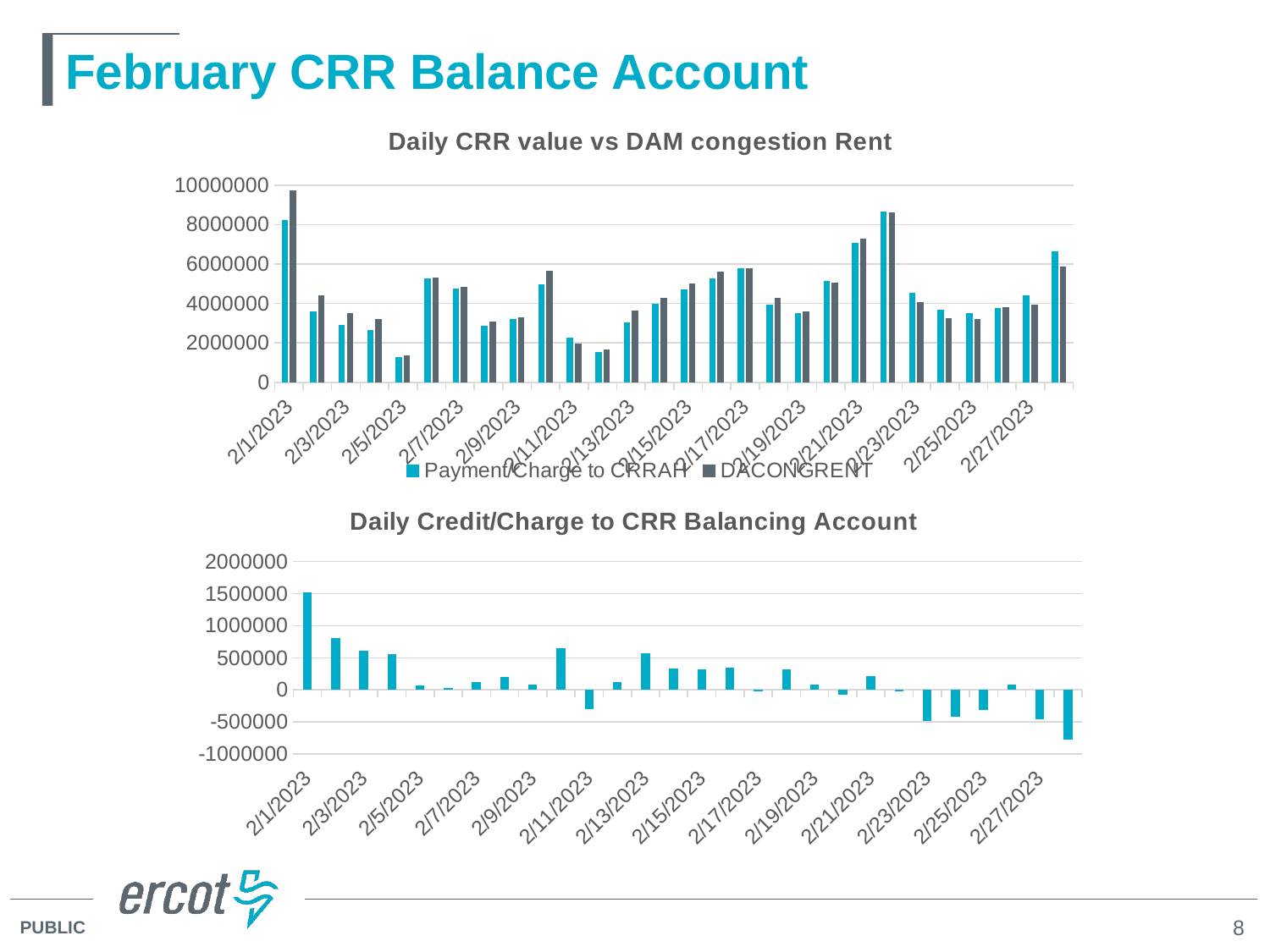
In the top chart, 'Daily CRR value vs DAM congestion Rent', is the Payment/Charge to CRRAH value for 2/22/2023 greater or less than 8000000? greater In the top chart, 'Daily CRR value vs DAM congestion Rent', what are the two legend entries? Payment/Charge to CRRAH and DACONGRENT In the top chart, 'Daily CRR value vs DAM congestion Rent', is the DACONGRENT value for 2/1/2023 greater or less than 8000000? greater In the top chart, 'Daily CRR value vs DAM congestion Rent', how many series does the legend list? 2 What kind of chart is the bottom chart, 'Daily Credit/Charge to CRR Balancing Account'? bar chart In the bottom chart, 'Daily Credit/Charge to CRR Balancing Account', on which date is the value lowest? 2/28/2023 In the bottom chart, 'Daily Credit/Charge to CRR Balancing Account', is the value for 2/1/2023 greater or less than 1000000? greater In the top chart, 'Daily CRR value vs DAM congestion Rent', which is larger on 2/1/2023: Payment/Charge to CRRAH or DACONGRENT? DACONGRENT In the bottom chart, 'Daily Credit/Charge to CRR Balancing Account', which date has the larger value: 2/2/2023 or 2/3/2023? 2/2/2023 In the bottom chart, 'Daily Credit/Charge to CRR Balancing Account', on which date is the value highest? 2/1/2023 In the top chart, 'Daily CRR value vs DAM congestion Rent', on which date is the DACONGRENT value highest? 2/1/2023